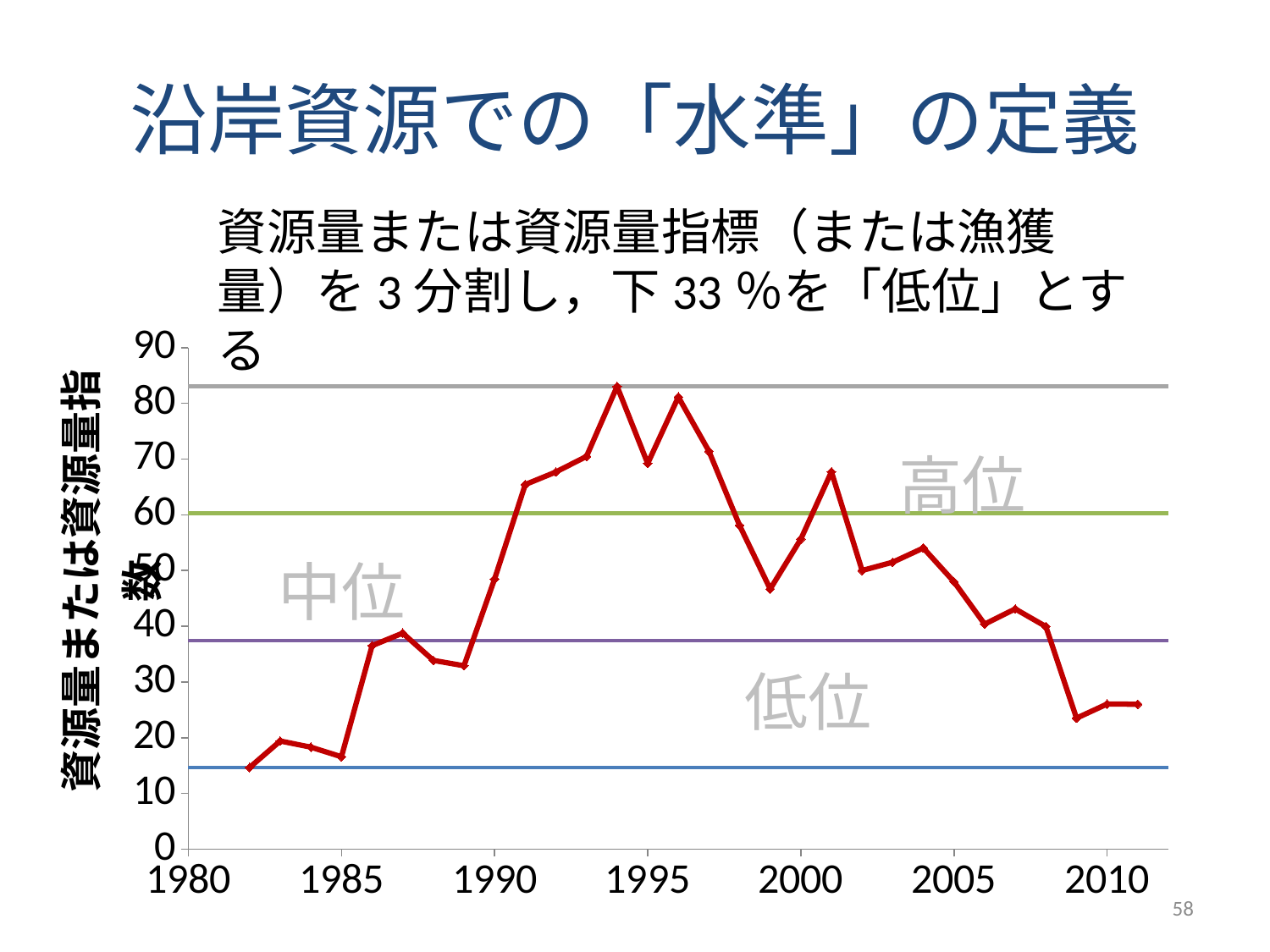
What are the three zone labels written on the chart area, from top to bottom? 高位, 中位, 低位 Which is larger, the value of the red line in 1994 or in 2001? 1994 Is the value of the red line in 1999 greater or less than 50? less Which is larger, the value of the red line in 1987 or in 1989? 1987 Is the value of the red line in 1994 greater or less than 70? greater Is the value of the red line in 1982 greater or less than 20? less In which year is the red line at its lowest value? 1982 Does the red line generally rise or fall between 1996 and 2009? fall What kind of chart is shown on the slide? line chart Does the red line generally rise or fall between 1982 and 1994? rise